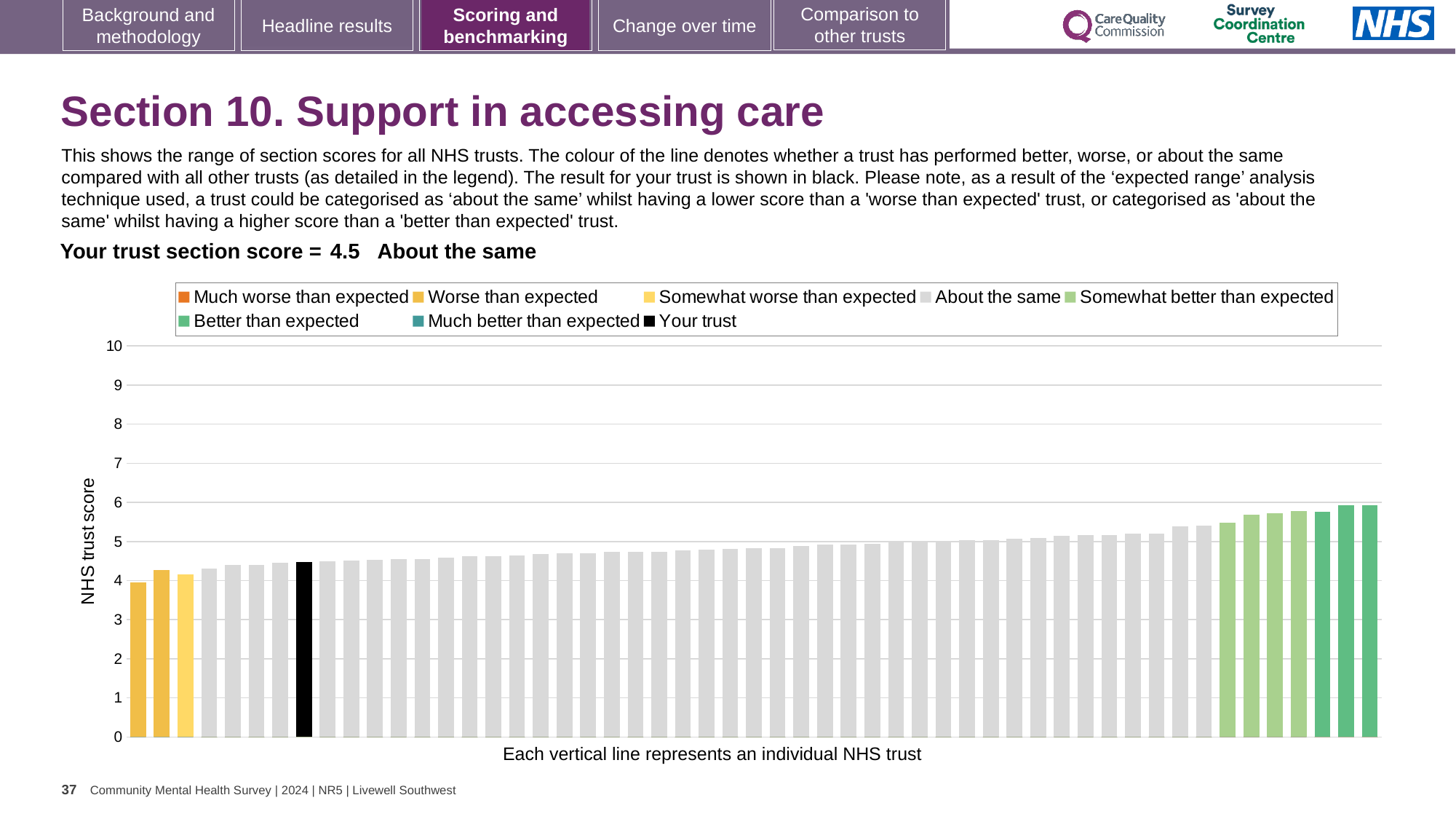
What colour is the bar representing your trust? black Which is larger, the value of the leftmost bar or the value of the rightmost bar? the rightmost bar Do the bar values rise or fall from left to right across the chart? rise What category is your trust's section score placed in, according to the text above the chart? About the same How many bars are coloured as 'Much worse than expected'? 0 Is the value of the highest bar greater or less than 5? greater Is the value of the lowest bar greater or less than 5? less How many entries does the chart legend list? 8 Is the value of the highest bar greater or less than 7? less What is the section score for your trust shown on the slide? 4.5 What kind of chart is shown on the slide? bar chart